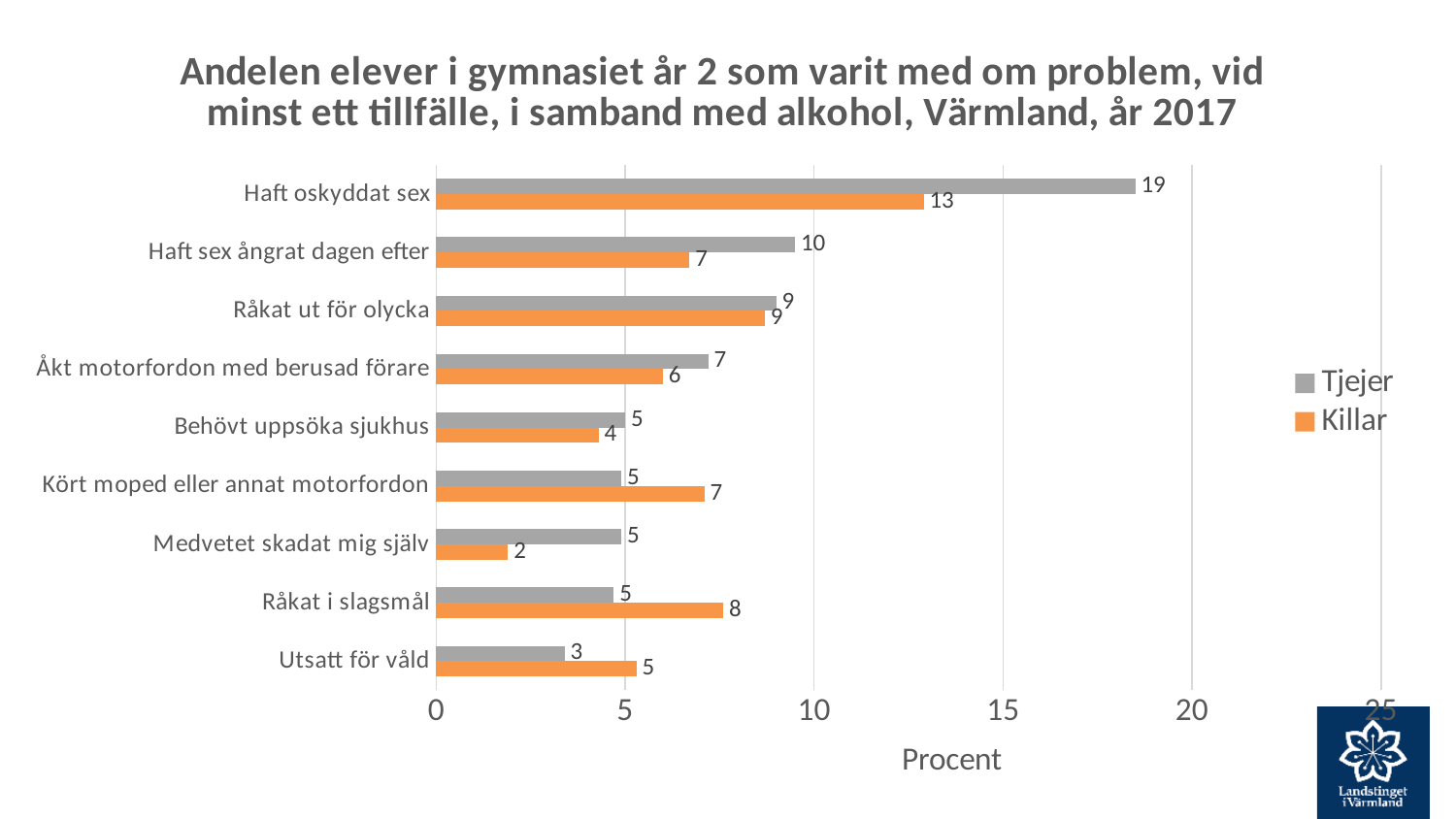
What is the label of the horizontal axis? Procent How many categories are shown on the chart? 9 What is the value for Killar for "Medvetet skadat mig själv"? 2 How many series does the legend list? 2 What kind of chart is shown on the slide? Bar chart For "Kört moped eller annat motorfordon", which is larger, the Tjejer value or the Killar value? Killar Which category has the highest value for Tjejer? Haft oskyddat sex Is the Tjejer value for "Haft sex ångrat dagen efter" greater or less than 5? greater What is the value for Tjejer for "Haft oskyddat sex"? 19 Which category has the lowest value for Killar? Medvetet skadat mig själv What is the difference between the Tjejer and Killar values for "Haft oskyddat sex"? 6 What is the value for Killar for "Råkat i slagsmål"? 8